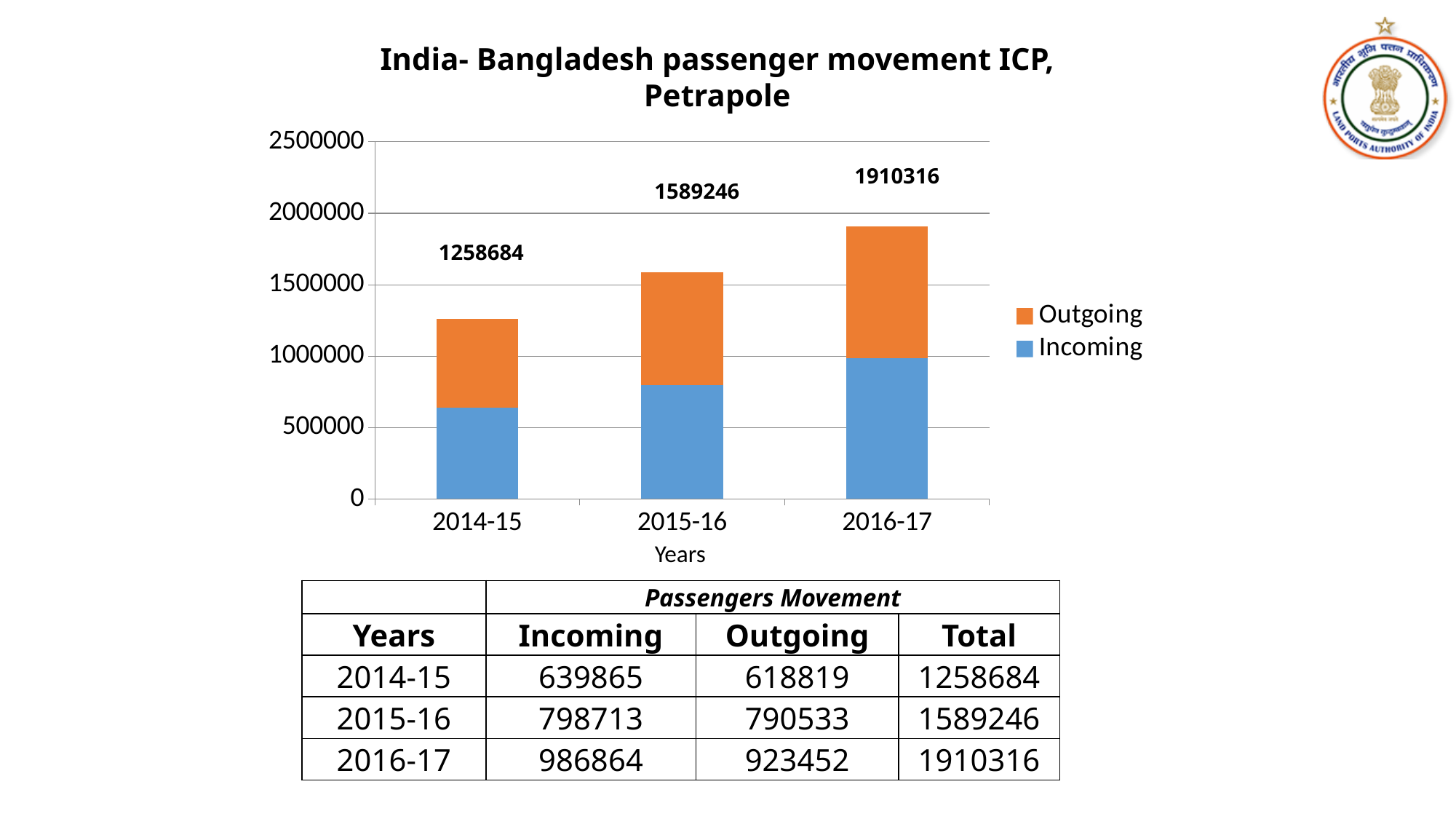
What is the total passenger movement shown above the bar for 2014-15? 1258684 How many series does the legend list? 2 Which year has the highest total passenger movement? 2016-17 What is the difference between the total passenger movement in 2016-17 and 2015-16? 321070 What is the Outgoing value for 2016-17? 923452 Is the Incoming value for 2014-15 larger or smaller than the Outgoing value for 2014-15? larger How many years are shown on the x axis? 3 What is the Incoming value for 2015-16? 798713 What is the total passenger movement shown above the bar for 2016-17? 1910316 Do the total passenger movement values rise or fall from 2014-15 to 2016-17? rise Is the total for 2015-16 greater or less than 1500000? greater Which year has the lowest total passenger movement? 2014-15